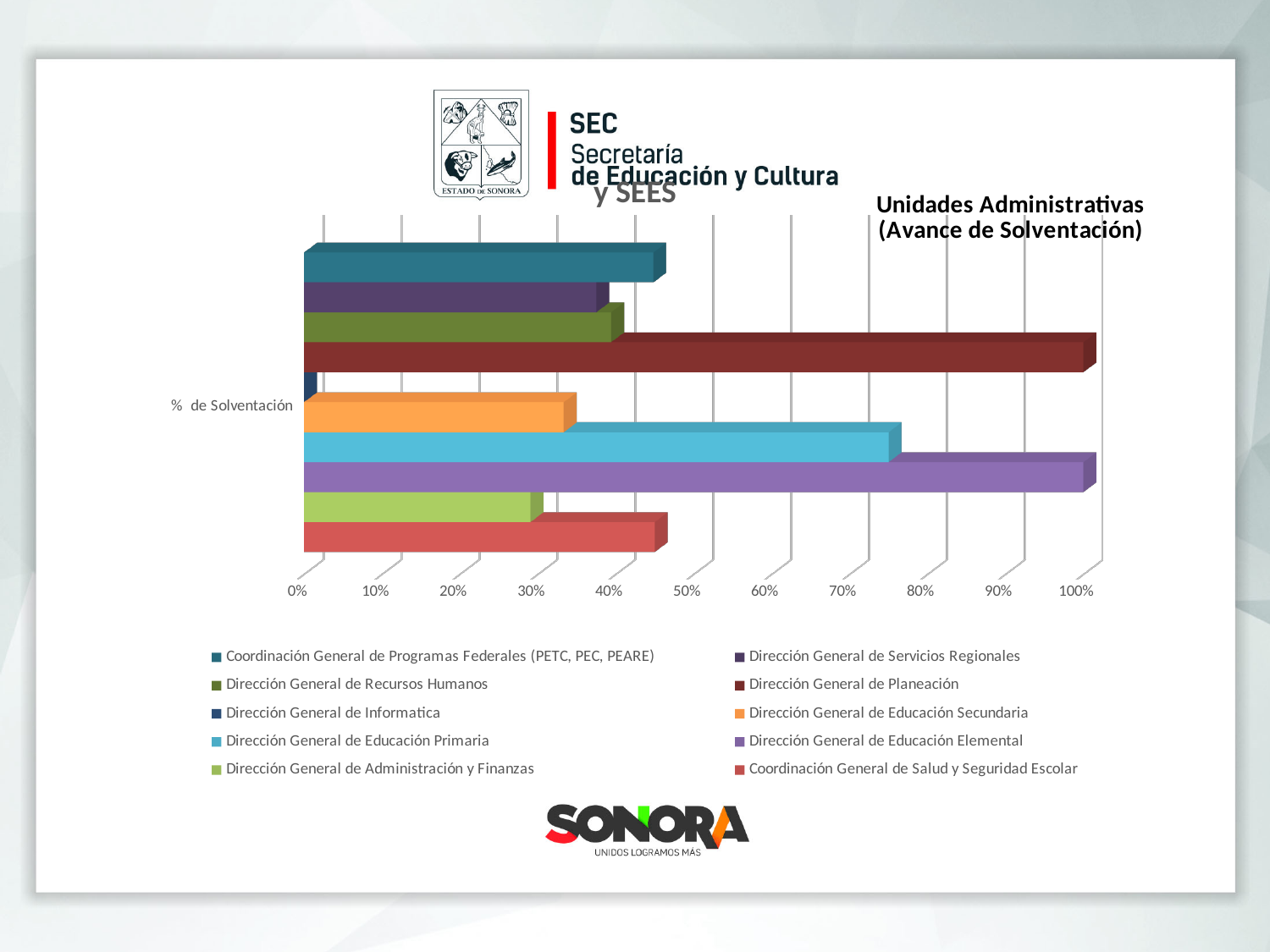
Is the value for Dirección General de Planeación greater or less than 90%? greater Which is larger, the value for Dirección General de Educación Primaria or Dirección General de Educación Secundaria? Dirección General de Educación Primaria Which is larger, the value for Dirección General de Informatica or Dirección General de Administración y Finanzas? Dirección General de Administración y Finanzas Is the value for Dirección General de Administración y Finanzas greater or less than 40%? less What is the label of the single category on the vertical axis? % de Solventación Which series has the lowest value? Dirección General de Informatica What is the title of the chart? Unidades Administrativas (Avance de Solventación) What kind of chart is shown on the slide? Bar chart Is the value for Coordinación General de Programas Federales (PETC, PEC, PEARE) greater or less than 40%? greater How many series does the legend list? 10